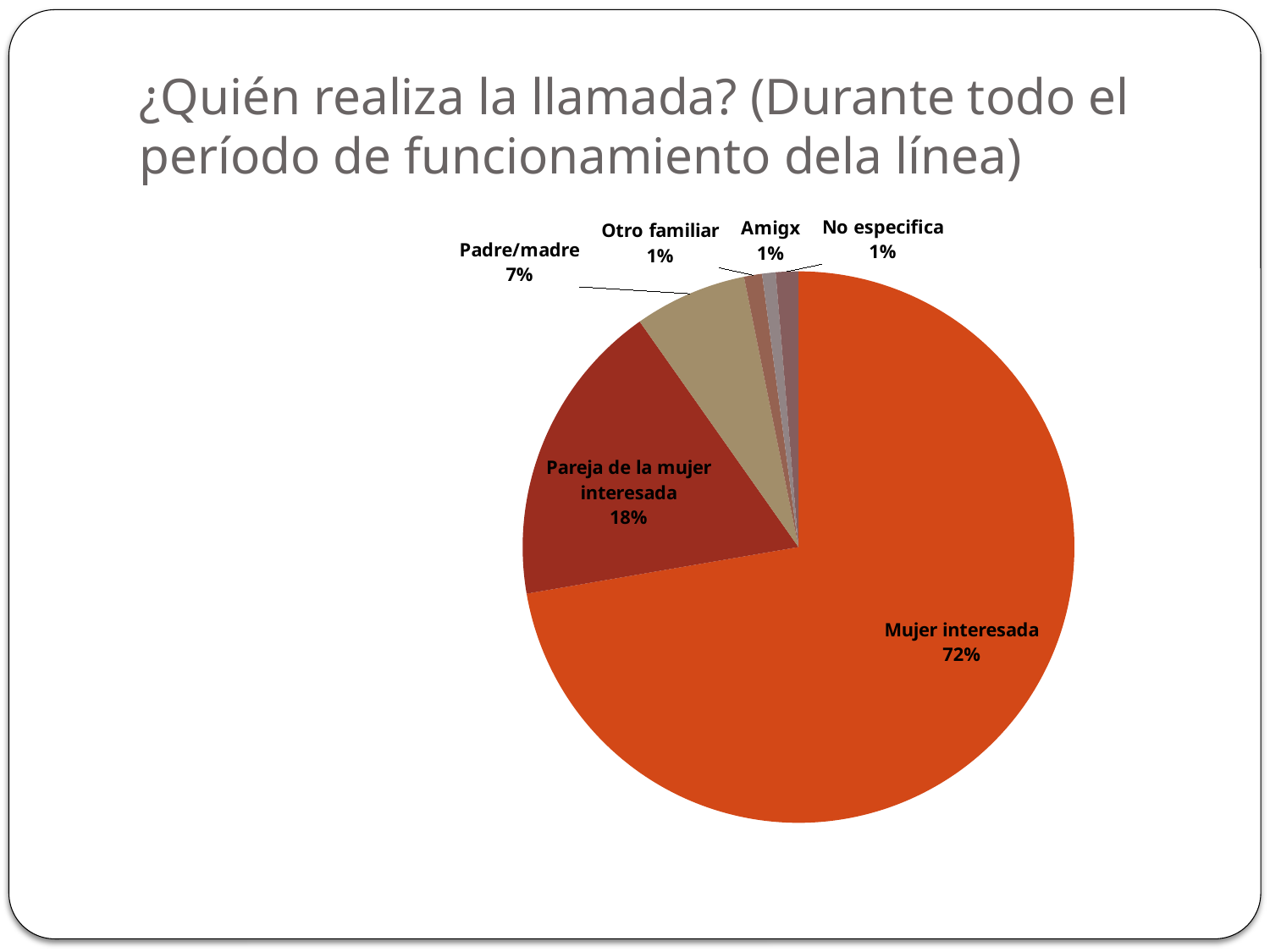
Which is larger, the share for "Padre/madre" or the share for "Amigx"? Padre/madre What share of the pie does "Pareja de la mujer interesada" represent? 18% What is the value for "Padre/madre"? 7% What is the title of the slide containing the chart? ¿Quién realiza la llamada? (Durante todo el período de funcionamiento dela línea) What is the value for "No especifica"? 1% Which category has the largest slice of the pie? Mujer interesada What share of the pie does "Mujer interesada" represent? 72% What is the value for "Otro familiar"? 1% How many slices does the pie chart have? 6 What is the difference between the shares for "Mujer interesada" and "Pareja de la mujer interesada"? 54% What kind of chart is shown on the slide? pie chart What is the difference between the shares for "Pareja de la mujer interesada" and "Padre/madre"? 11%